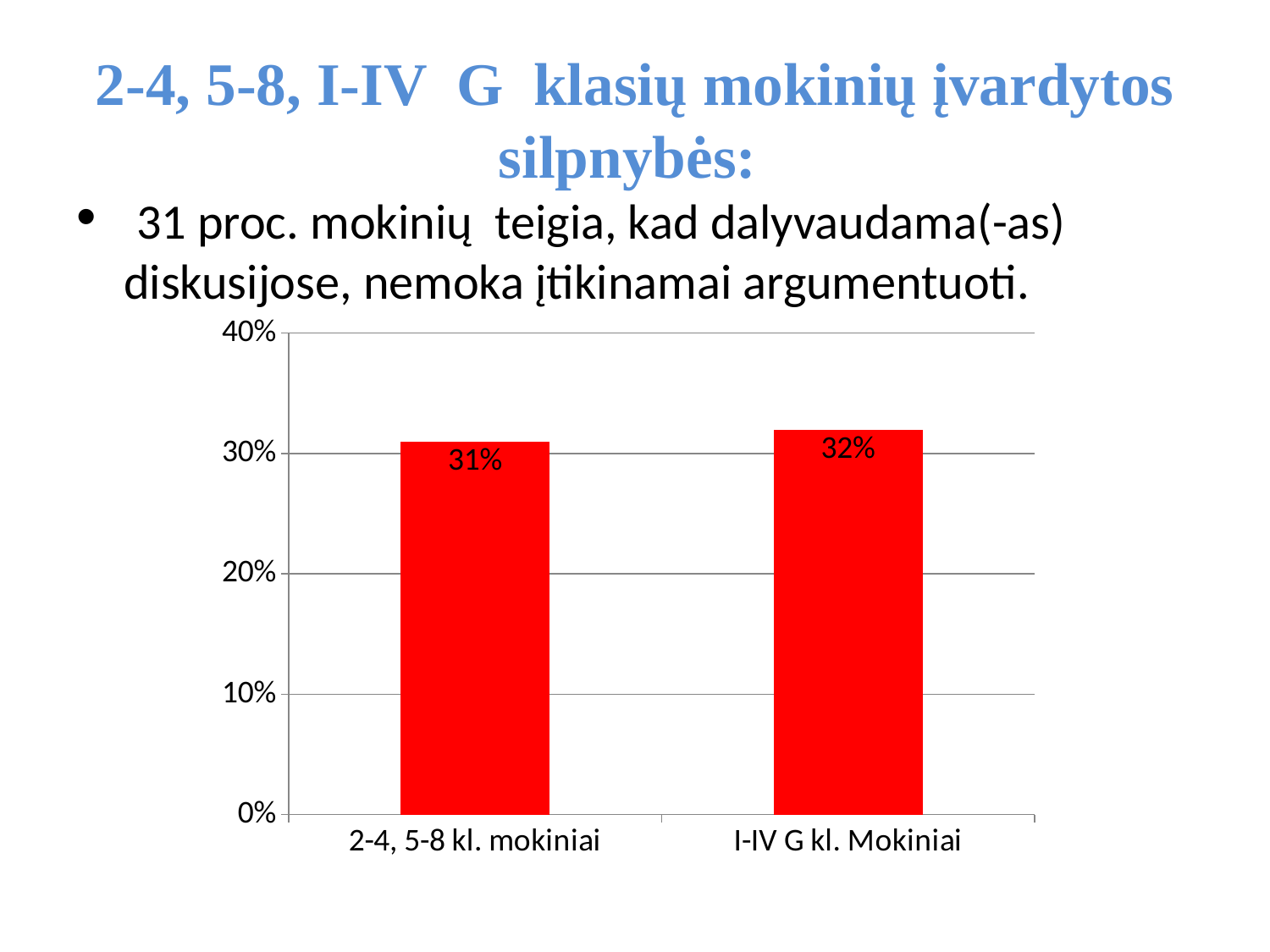
What kind of chart is shown on the slide? bar chart What is the highest value shown on the vertical axis? 40% Which is larger, the value for 2-4, 5-8 kl. mokiniai or the value for I-IV G kl. Mokiniai? I-IV G kl. Mokiniai What is the value for 2-4, 5-8 kl. mokiniai? 31% Is the value for 2-4, 5-8 kl. mokiniai greater or less than 20%? greater Which category has the highest value? I-IV G kl. Mokiniai How many categories are shown on the x axis? 2 What is the difference between the values for I-IV G kl. Mokiniai and 2-4, 5-8 kl. mokiniai? 1% What colour are the bars in the chart? red Is the value for I-IV G kl. Mokiniai greater or less than 40%? less Which category has the lowest value? 2-4, 5-8 kl. mokiniai What is the value for I-IV G kl. Mokiniai? 32%